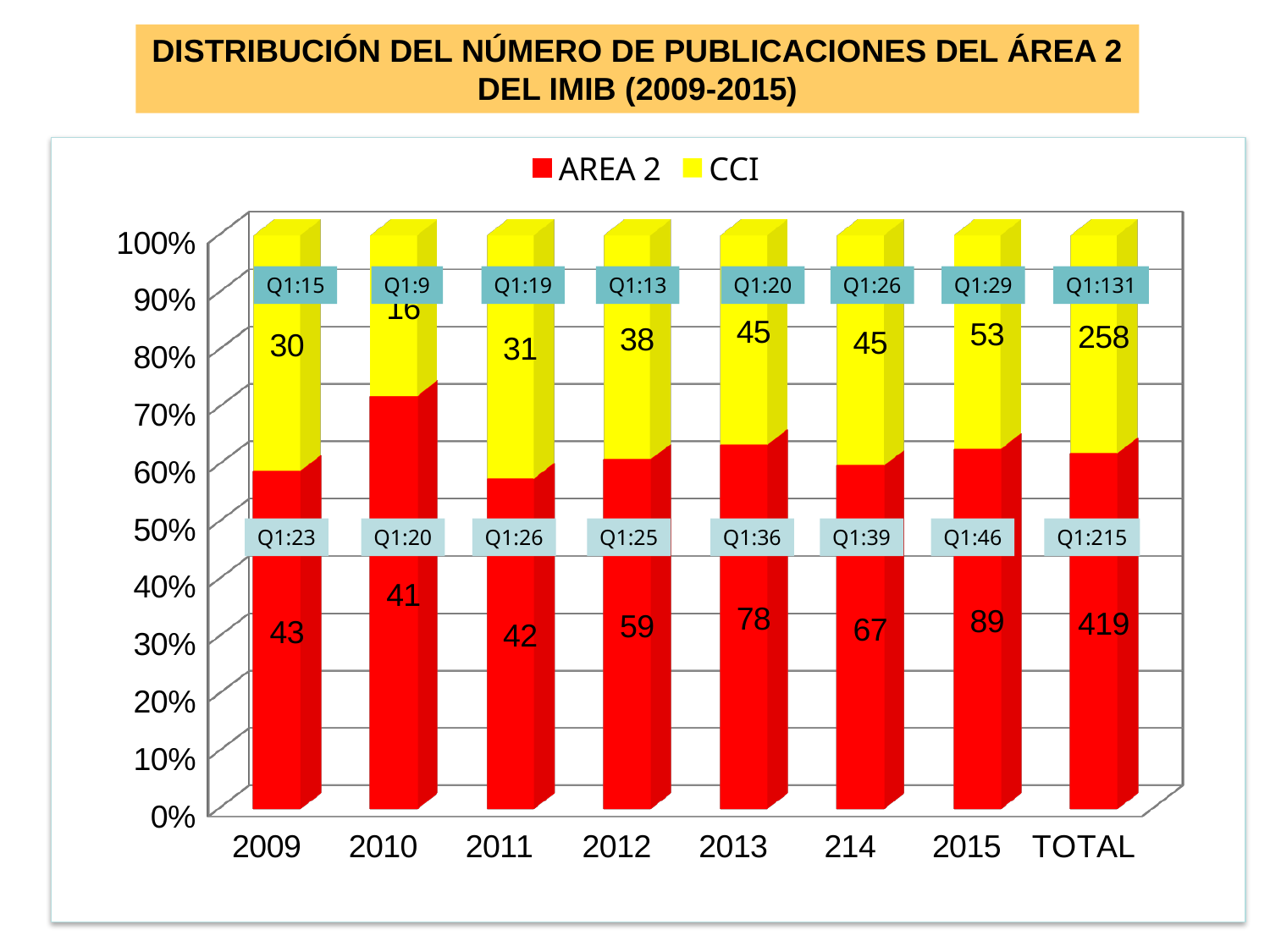
What is the difference between the AREA 2 value for 2015 and the AREA 2 value for 2009? 46 What kind of chart is shown on the slide? Stacked bar chart What is the CCI value for 2012? 38 How many categories are shown on the x axis? 8 Excluding TOTAL, which year has the lowest CCI value? 2010 What is the CCI value for 2010? 16 What is the sum of the AREA 2 and CCI values for 2012? 97 Excluding TOTAL, which year has the highest AREA 2 value? 2015 Which is larger, the CCI value for 2011 or the CCI value for 2015? 2015 What is the AREA 2 value for 2013? 78 What is the AREA 2 value for TOTAL? 419 How many series does the legend list? 2